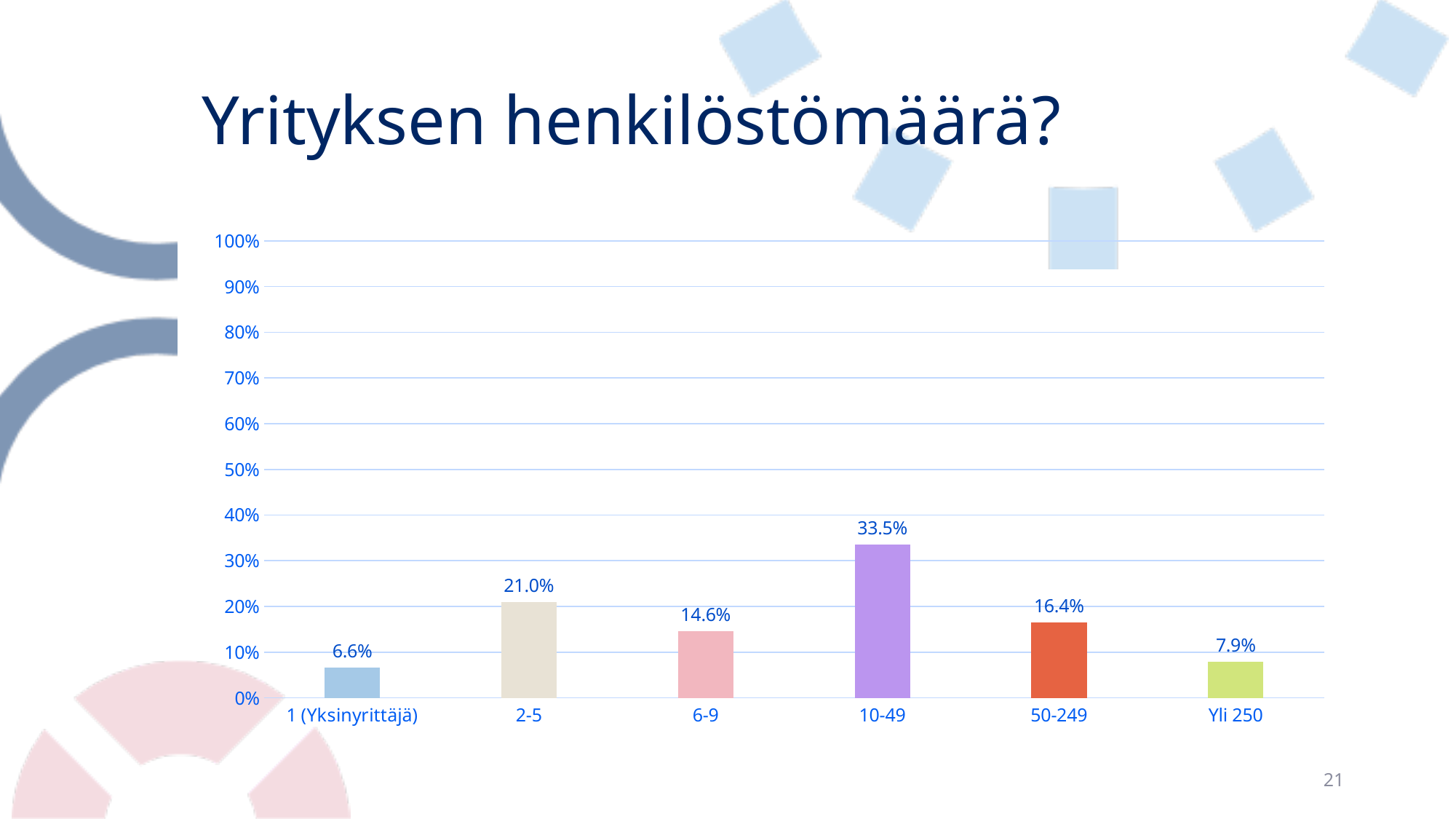
What is the difference between the values for 10-49 and 2-5? 12.5% How many categories are shown on the x axis? 6 What is the difference between the values for 50-249 and 6-9? 1.8% What is the value for the 10-49 category? 33.5% Which category has the lowest value? 1 (Yksinyrittäjä) Which category has the highest value? 10-49 What is the title of the slide? Yrityksen henkilöstömäärä? What is the value for the Yli 250 category? 7.9% What kind of chart is shown on the slide? bar chart Is the value for 10-49 greater or less than 30%? greater Which is larger, the value for 2-5 or the value for 50-249? 2-5 What is the value for the 1 (Yksinyrittäjä) category? 6.6%